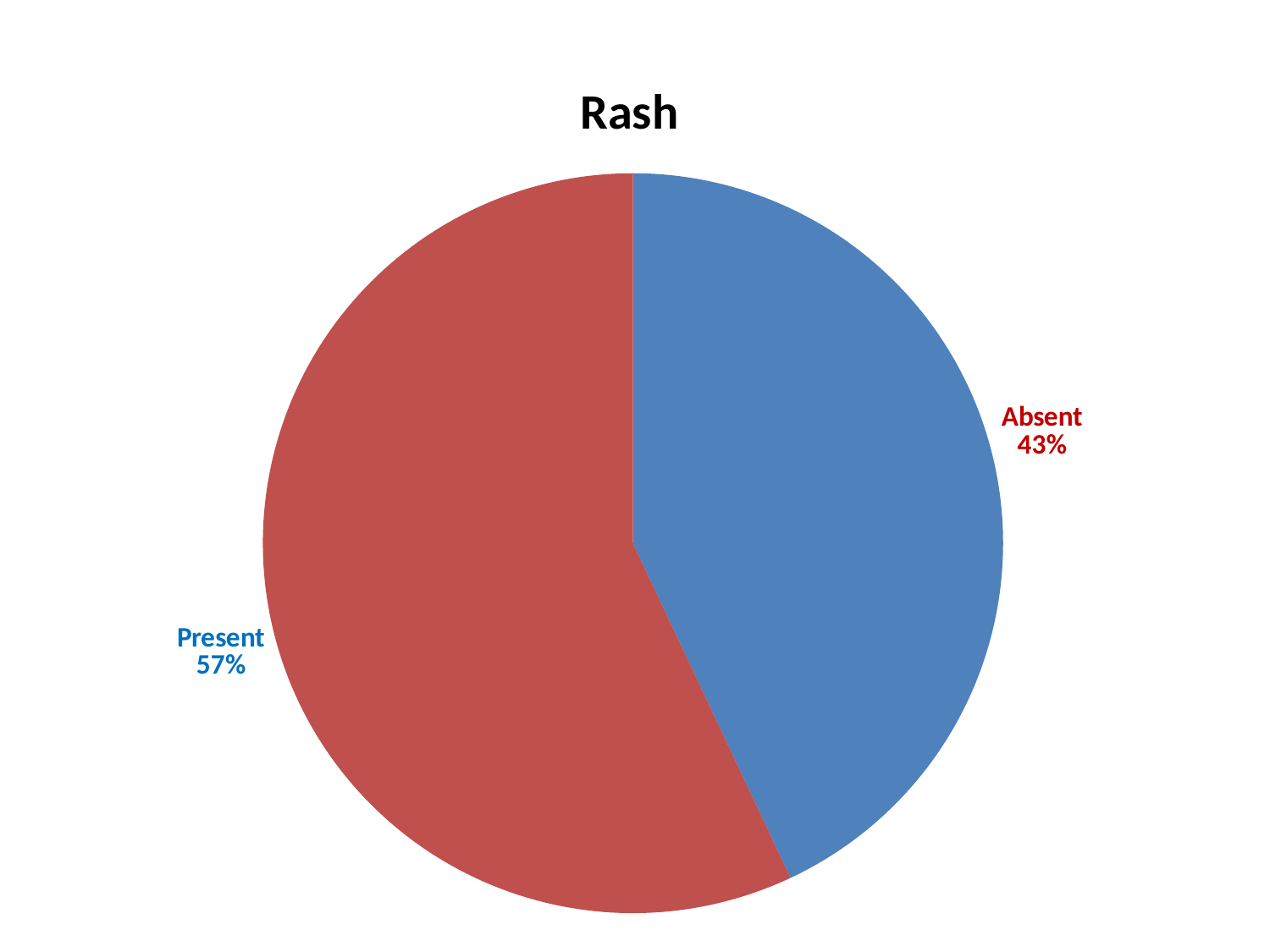
Which is larger, the share for Present or the share for Absent? Present What percentage of the pie is labelled Present? 57% What share of the pie does the Present slice take up? 57% Is the share for Present greater or less than half of the pie? greater What is the title of the chart? Rash Which category has the largest share of the pie? Present By how many percentage points does the Present share exceed the Absent share? 14 percentage points What kind of chart is shown on the slide? Pie chart How many slices does the pie chart have? 2 Which category has the smallest share of the pie? Absent What percentage of the pie is labelled Absent? 43%